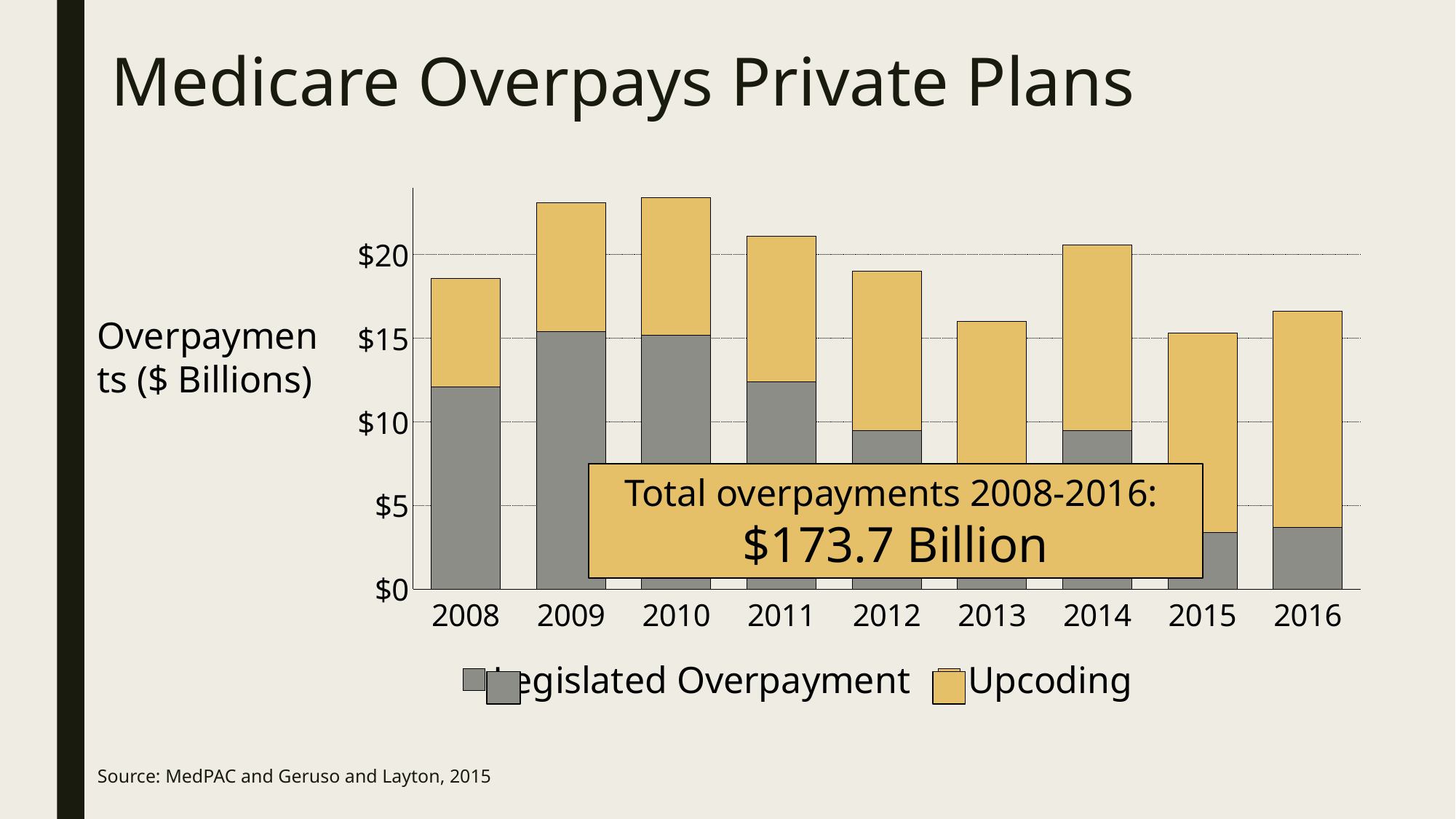
Is the total overpayment bar for 2012 greater or less than $20? less Does the Legislated Overpayment series generally rise or fall from 2010 to 2016? fall Is the total overpayment bar for 2009 greater or less than $20? greater How many series does the chart's legend list? 2 Is the total overpayment bar for 2008 greater or less than $20? less What total overpayment figure for 2008-2016 is printed on the chart? $173.7 Billion What are the two series named in the chart's legend? Legislated Overpayment and Upcoding How many years are shown on the x axis of the chart? 9 Which year has the larger total overpayment bar, 2008 or 2009? 2009 What kind of chart is shown on the slide? Stacked bar chart